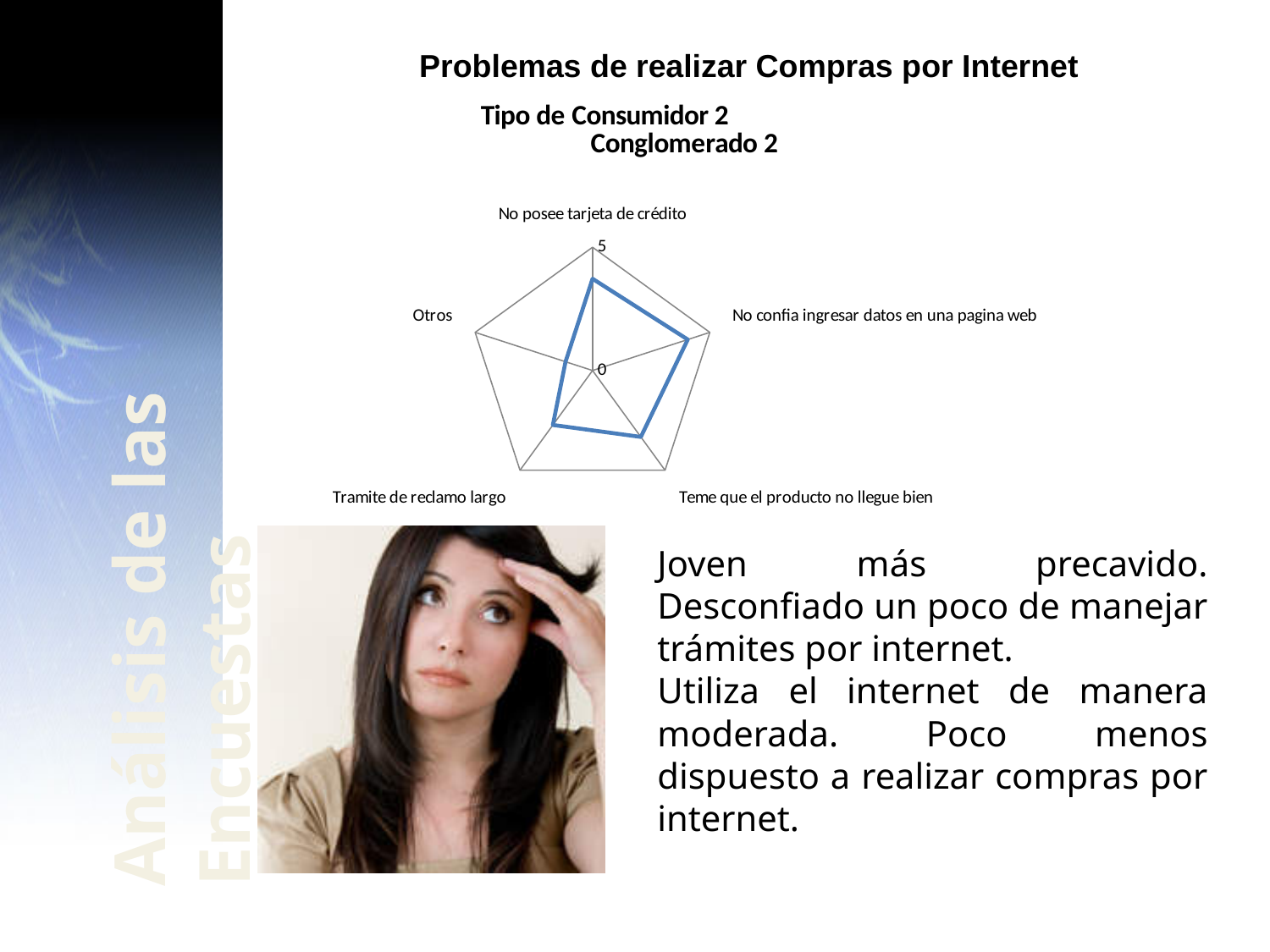
How many categories (axes) does the radar chart have? 5 Is the value for No confia ingresar datos en una pagina web greater or less than 5? less What kind of chart is shown on the slide? Radar chart Which category has the lowest value in the radar chart? Otros What is the maximum value shown on the radar chart's axis scale? 5 Which is larger, the value for Otros or the value for Teme que el producto no llegue bien? Teme que el producto no llegue bien What is the title of the chart? Tipo de Consumidor 2 Conglomerado 2 Which is larger, the value for Otros or the value for No confia ingresar datos en una pagina web? No confia ingresar datos en una pagina web Is the value for Otros greater or less than 5? less